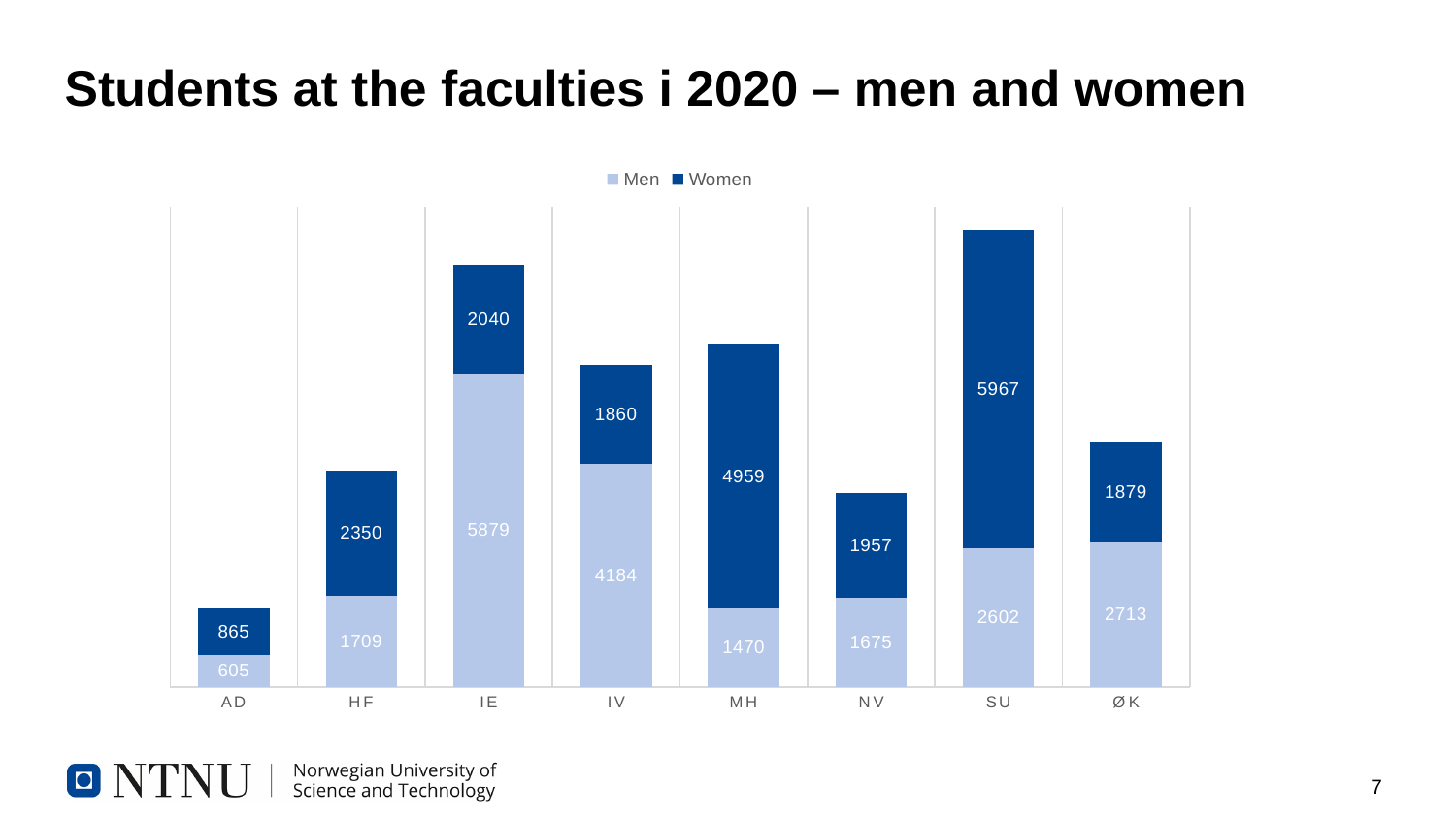
What kind of chart is shown on the slide? Stacked bar chart What is the total number of students at the AD faculty? 1470 How many women students are at the SU faculty? 5967 How many faculties are shown on the x axis? 8 Which is larger at the ØK faculty, the number of men or the number of women? Men Which faculty has the lowest number of men students? AD Which faculty has the highest number of women students? SU How many series does the legend list? 2 How many men students are at the IE faculty? 5879 How many men students are at the MH faculty? 1470 What is the total number of students at the HF faculty? 4059 What is the difference between the number of women and men at the MH faculty? 3489